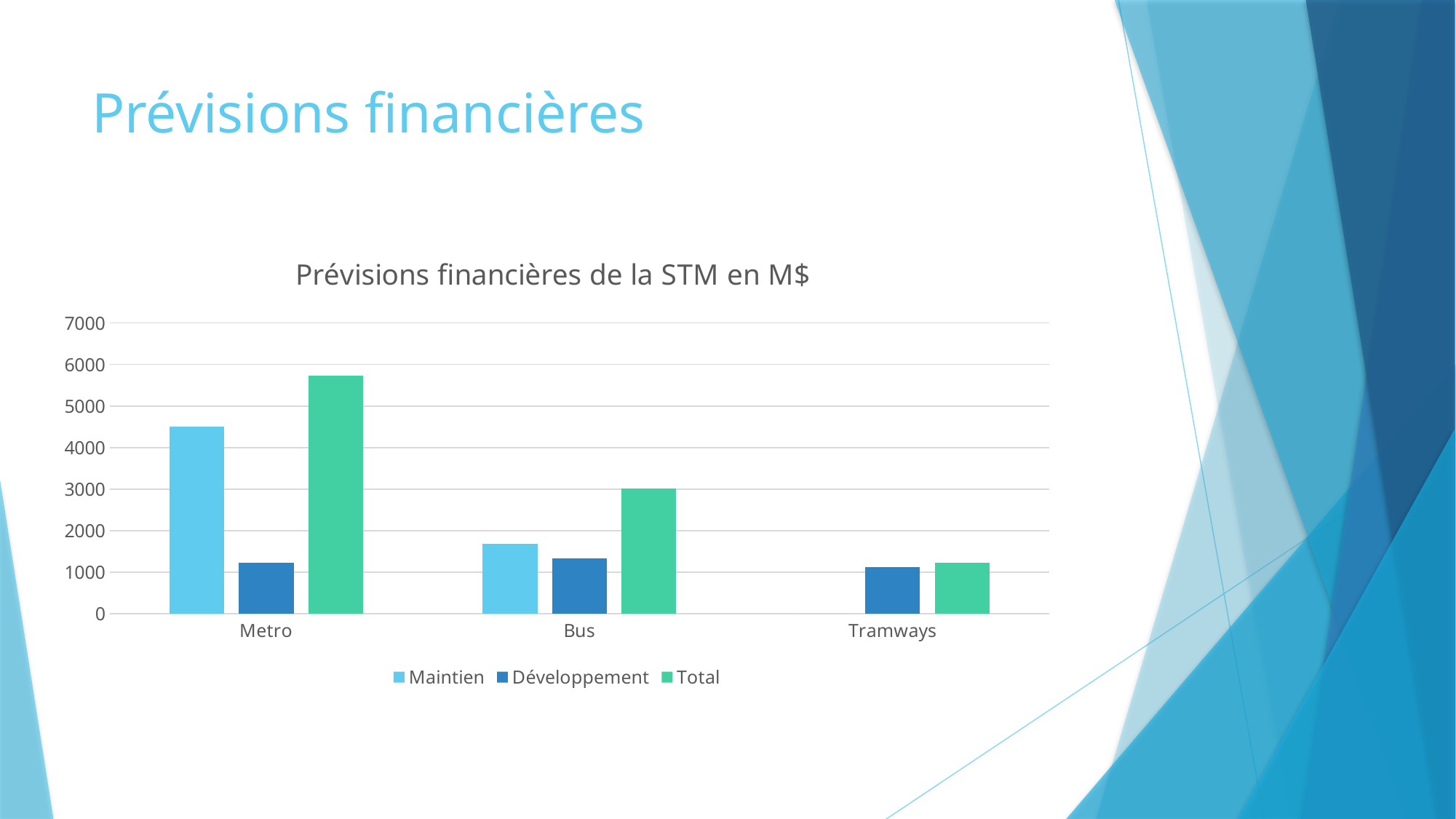
Which category has the lowest Total value? Tramways How many categories are shown on the x axis? 3 How many series does the legend list? 3 Which category has the highest Total value? Metro Is the Total value for Metro greater or less than 5000? greater Is the Développement value for Tramways greater or less than 2000? less What kind of chart is shown on the slide? bar chart Which is larger, the Maintien value for Metro or the Maintien value for Bus? Metro Is the Maintien value for Bus greater or less than 2000? less Which series is shown in green in the legend? Total What is the title of the chart? Prévisions financières de la STM en M$